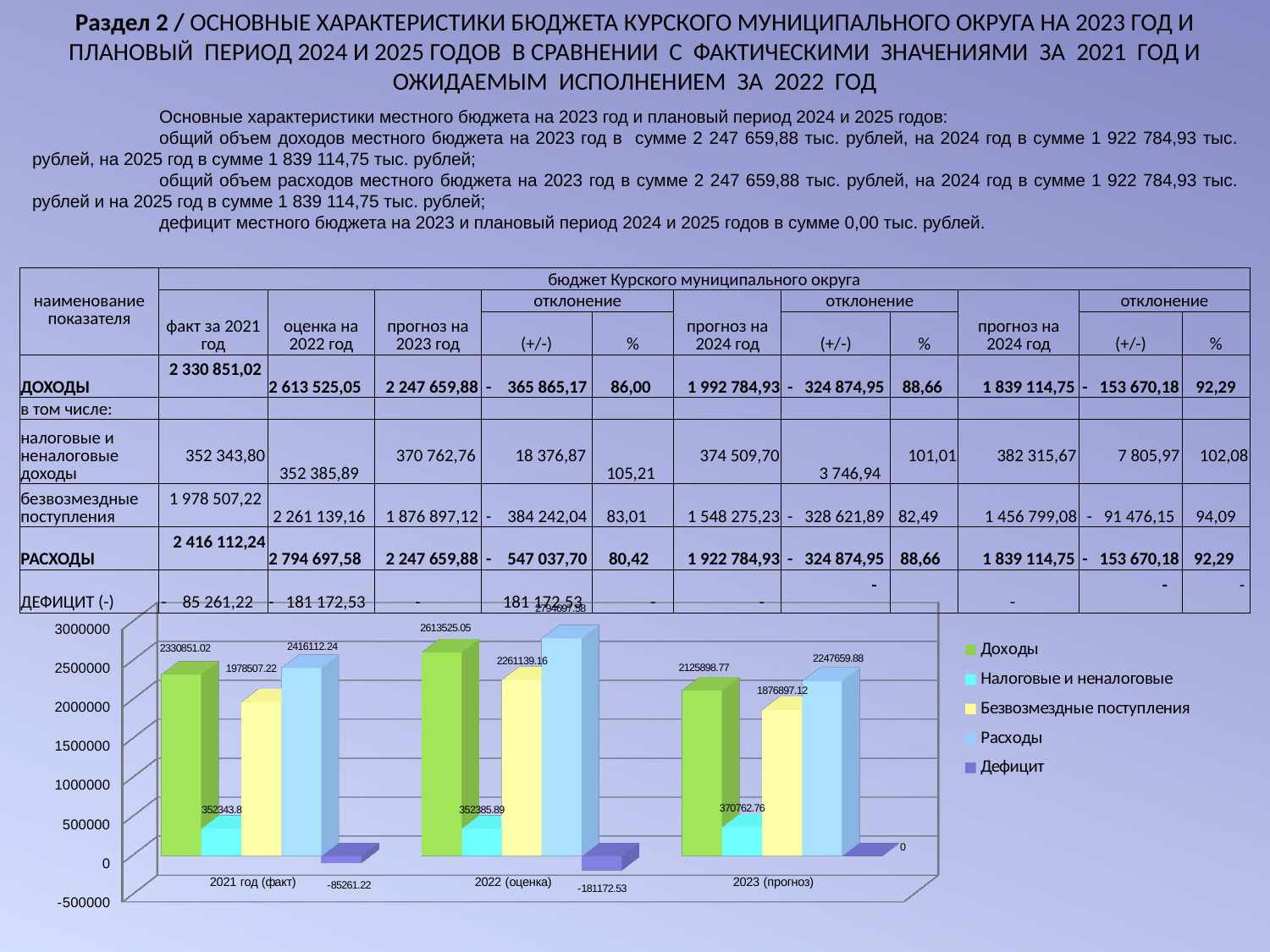
What is the value of Налоговые и неналоговые for 2023 (прогноз) in the chart? 370762.76 How many year categories are shown on the x axis of the chart? 3 What type of chart is shown at the bottom of the slide? bar chart How many series does the chart legend list? 5 In which year category is Безвозмездные поступления lowest in the chart? 2023 (прогноз) Is the value of Безвозмездные поступления for 2022 (оценка) greater or less than 2000000? greater Which is larger in the chart for 2021 год (факт): Доходы or Расходы? Расходы What is the value of Доходы for 2021 год (факт) in the chart? 2330851.02 What is the value of Дефицит for 2022 (оценка) in the chart? -181172.53 What is the value of Расходы for 2022 (оценка) in the chart? 2794697.58 What is the difference between Расходы and Доходы for 2023 (прогноз) in the chart? 121761.11 In which year category is Расходы highest in the chart? 2022 (оценка)